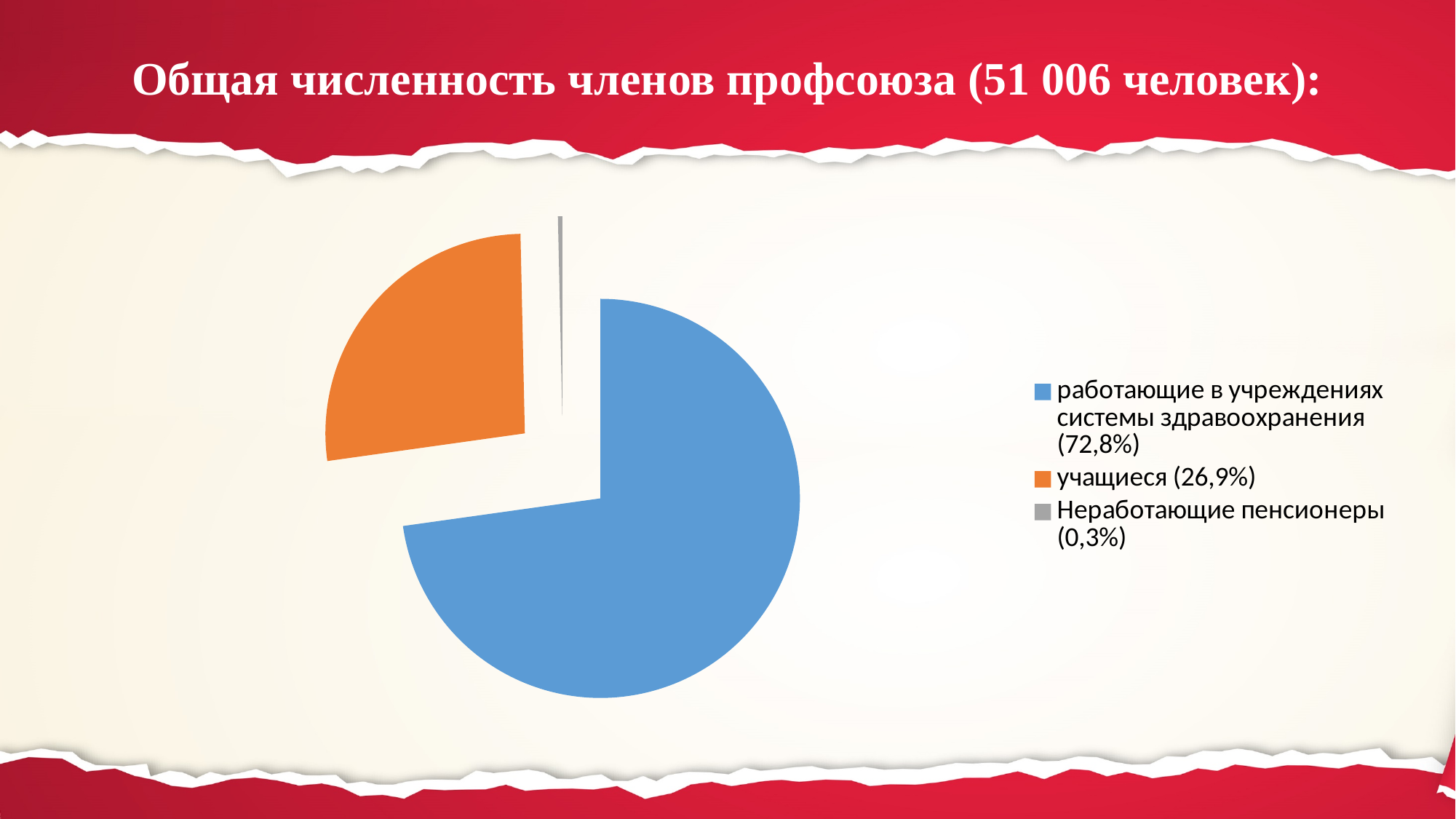
What share of the pie is taken by "Неработающие пенсионеры"? 0,3% What share of the pie is taken by "учащиеся"? 26,9% What is the difference in percentage points between the share of "учащиеся" and the share of "Неработающие пенсионеры"? 26,6 What total number of union members is given in the slide title? 51 006 человек Which is larger: the share of "учащиеся" or the share of "Неработающие пенсионеры"? учащиеся What is the difference in percentage points between the share of "работающие в учреждениях системы здравоохранения" and the share of "учащиеся"? 45,9 What share of the pie is taken by "работающие в учреждениях системы здравоохранения"? 72,8% What colour is the slice for "учащиеся"? Orange What kind of chart is shown on the slide? Pie chart How many slices does the pie chart have? 3 Which category has the largest slice of the pie? работающие в учреждениях системы здравоохранения Which category has the smallest slice of the pie? Неработающие пенсионеры